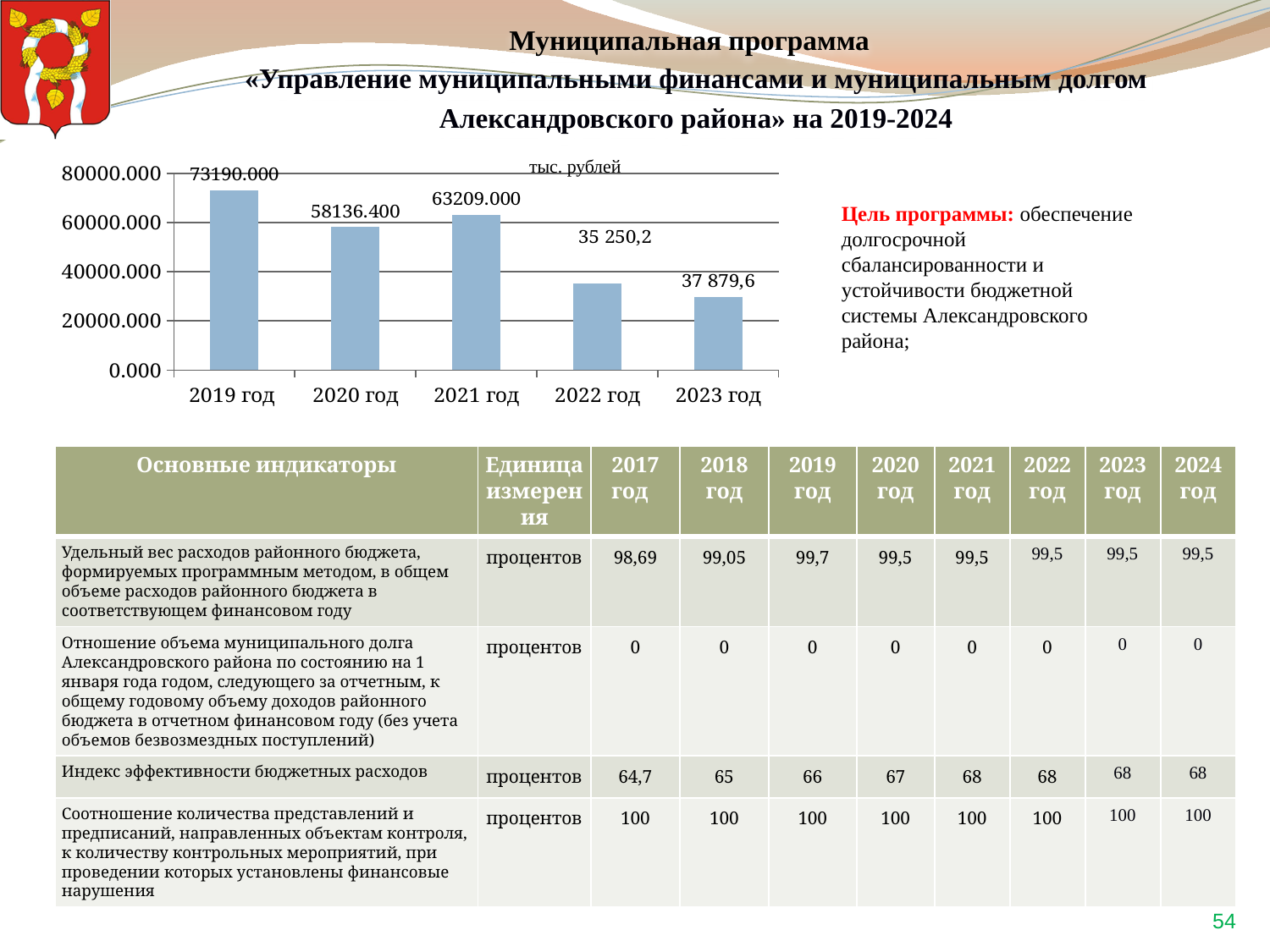
Which is larger in the bar chart, the value for 2020 год or 2021 год? 2021 год What is the value shown for 2021 год in the bar chart? 63209.000 What is the difference between the values for 2019 год and 2020 год in the bar chart? 15053.600 Which year has the highest value in the bar chart? 2019 год What is the value shown for 2020 год in the bar chart? 58136.400 What is the value labelled for 2022 год in the bar chart? 35 250,2 How many years (categories) are plotted in the bar chart? 5 What is the value labelled for 2023 год in the bar chart? 37 879,6 Is the value for 2022 год in the bar chart greater or less than 40000.000? less What unit is given in the title of the bar chart? тыс. рублей What is the value shown for 2019 год in the bar chart? 73190.000 What type of chart is shown on the slide? bar chart